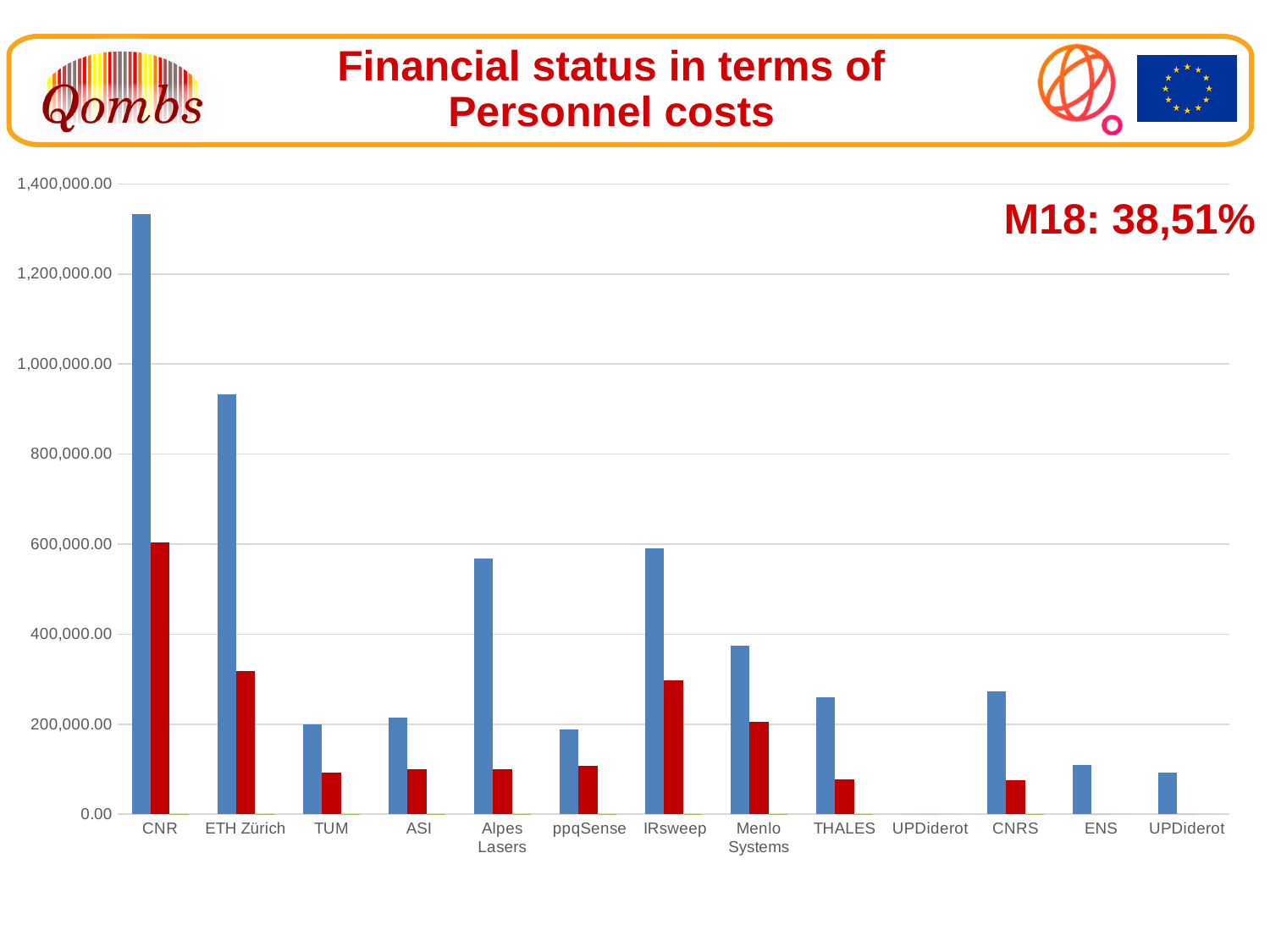
Which has the taller blue bar, Menlo Systems or THALES? Menlo Systems Is the blue bar for CNR greater or less than 1,200,000.00? greater Is the red bar for ETH Zürich greater or less than 200,000.00? greater What kind of chart is shown on the slide? bar chart Is the blue bar for Menlo Systems greater or less than 400,000.00? less Which has the taller blue bar, CNR or ETH Zürich? CNR What is the title of the slide containing the chart? Financial status in terms of Personnel costs Which category has the tallest bar in the chart? CNR How many categories are shown along the x axis of the chart? 13